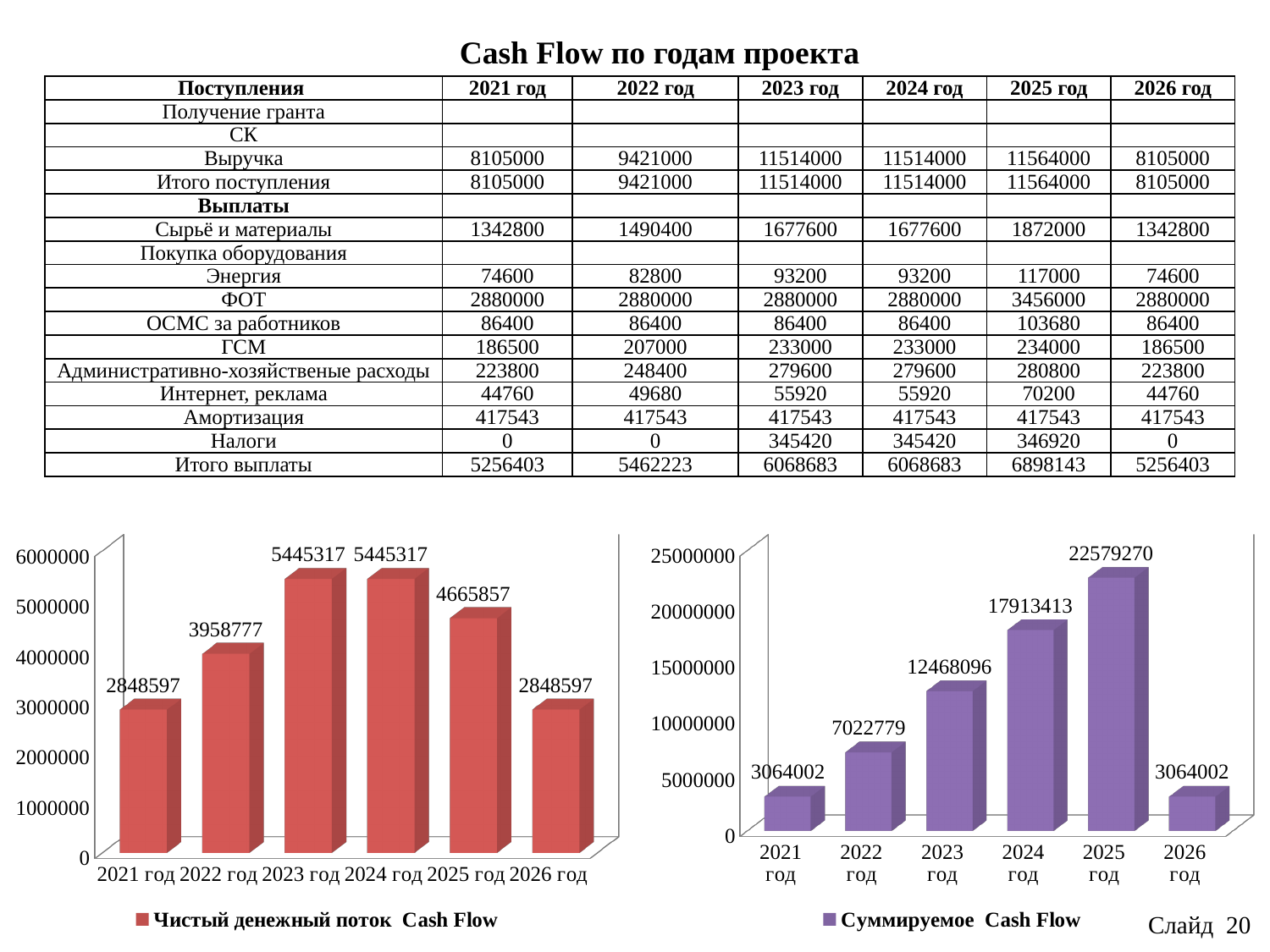
In the left chart (Чистый денежный поток Cash Flow), what is the difference between the values for 2023 год and 2021 год? 2596720 In the right chart (Суммируемое Cash Flow), what is the value for 2024 год? 17913413 In the right chart (Суммируемое Cash Flow), is the value for 2023 год greater or less than 10000000? greater In the left chart (Чистый денежный поток Cash Flow), what is the value for 2022 год? 3958777 In the left chart (Чистый денежный поток Cash Flow), what is the value for 2025 год? 4665857 In the right chart (Суммируемое Cash Flow), which year has the highest value? 2025 год How many years are shown on the x axis of the left chart (Чистый денежный поток Cash Flow)? 6 What is the legend entry of the left chart? Чистый денежный поток Cash Flow In the right chart (Суммируемое Cash Flow), do the values rise or fall from 2021 год to 2025 год? rise In the right chart (Суммируемое Cash Flow), what is the difference between the values for 2023 год and 2022 год? 5445317 What kind of chart is the right chart (Суммируемое Cash Flow)? bar chart In the left chart (Чистый денежный поток Cash Flow), which year has the lowest value, 2022 год or 2025 год? 2022 год